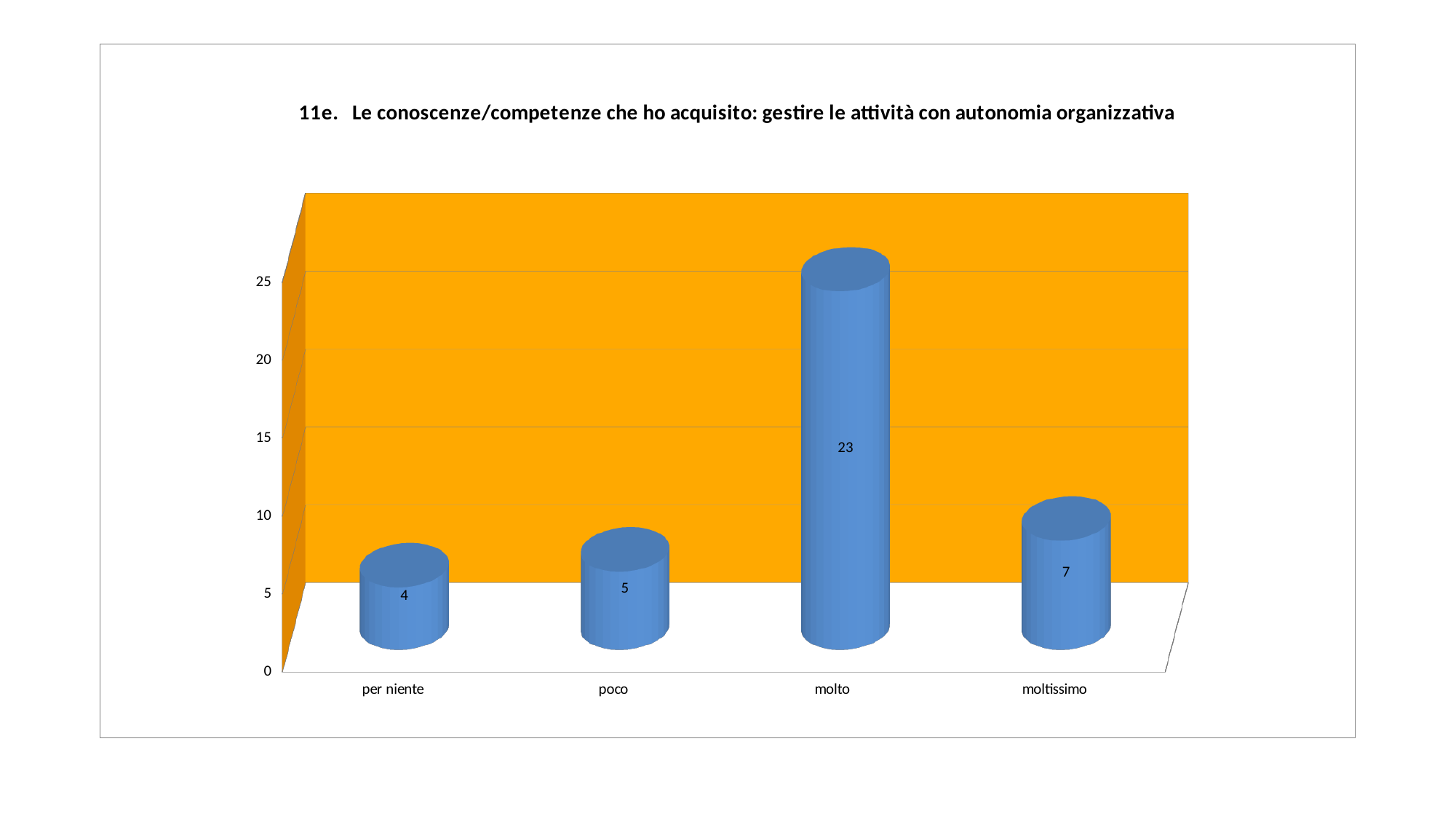
What is the value for "moltissimo"? 7 Which category has the highest value? molto Which is larger, the value for "poco" or the value for "moltissimo"? moltissimo What is the value for "per niente"? 4 What is the difference between the values for "molto" and "moltissimo"? 16 How many categories are shown on the x axis? 4 Is the value for "molto" greater or less than 20? greater What is the value for "molto"? 23 What kind of chart is shown on the slide? bar chart Which category has the lowest value? per niente What is the value for "poco"? 5 What is the total of all four values shown in the chart? 39